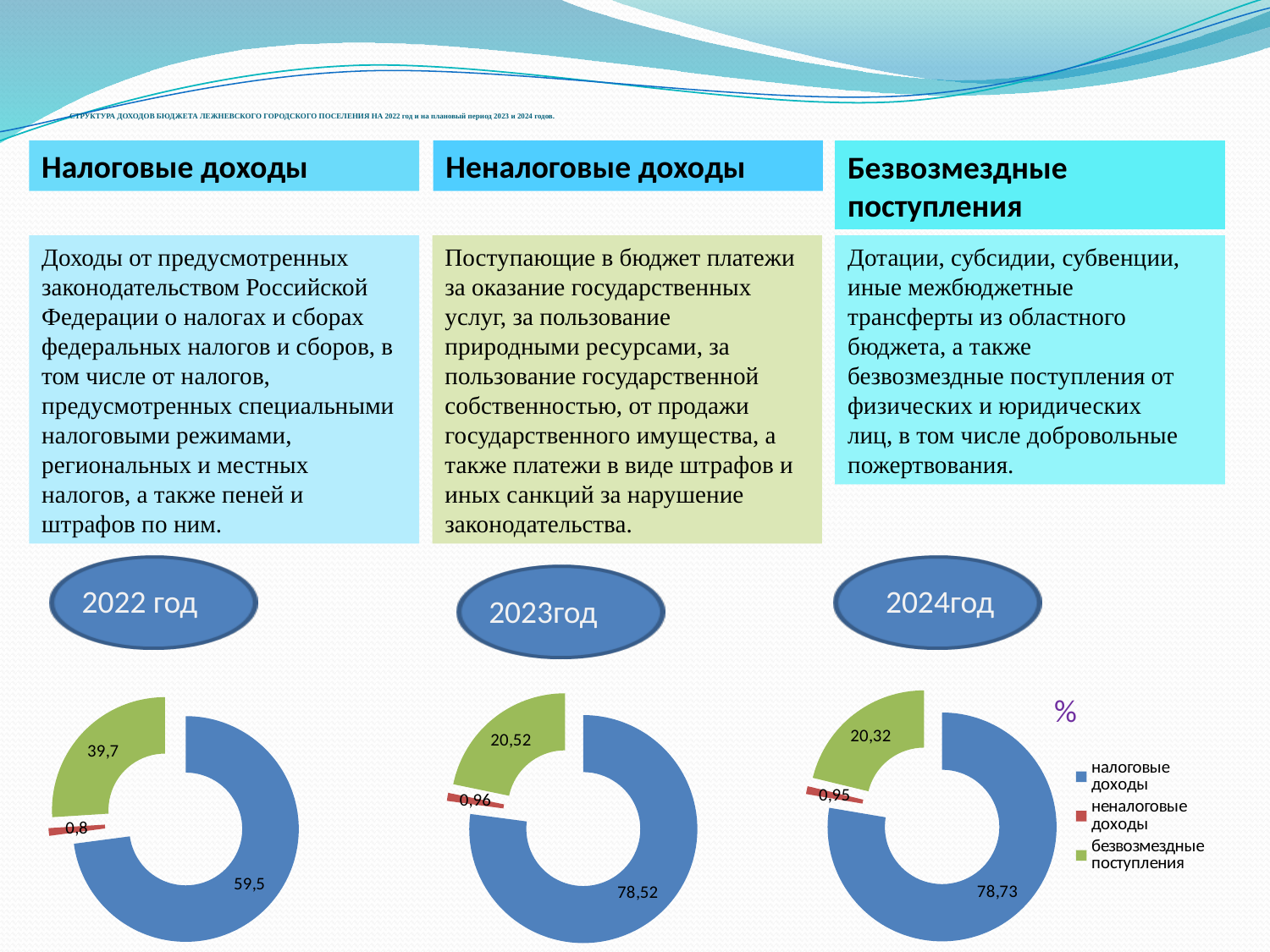
How many categories does each doughnut chart show? 3 In the 2023год chart, what is the value for неналоговые доходы? 0,96 In the 2022 год chart, what is the value for безвозмездные поступления? 39,7 In the legend, which colour represents неналоговые доходы? red In the 2022 год chart, what is the difference between the values for налоговые доходы and безвозмездные поступления? 19,8 In the 2022 год chart, what is the value for налоговые доходы? 59,5 What kind of chart is used for the 2022 год data? doughnut chart In the 2024год chart, what is the value for налоговые доходы? 78,73 In the 2024год chart, which category has the smallest value? неналоговые доходы Which is larger: безвозмездные поступления in the 2023год chart or in the 2024год chart? 2023год In the 2023год chart, which category has the largest value? налоговые доходы How many series does the legend list? 3